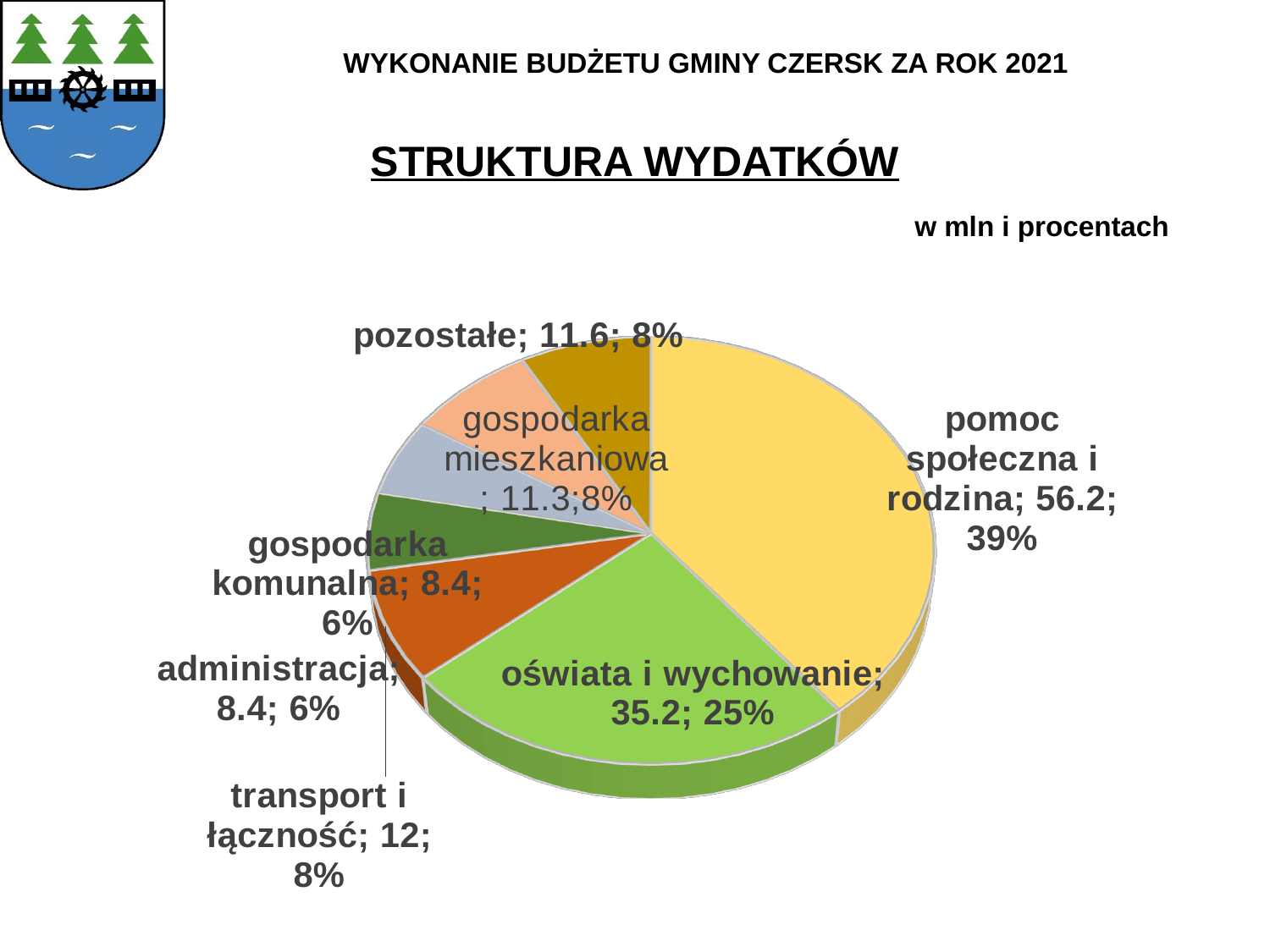
Which category has the largest slice of the pie? pomoc społeczna i rodzina What kind of chart is shown on the slide? pie chart What is the value in mln for "administracja"? 8.4 What is the difference in mln between "pomoc społeczna i rodzina" and "oświata i wychowanie"? 21 What is the value in mln for "transport i łączność"? 12 What is the title of the chart? STRUKTURA WYDATKÓW Which is larger, the value for "pozostałe" or the value for "gospodarka mieszkaniowa"? pozostałe What is the value in mln for "pomoc społeczna i rodzina"? 56.2 What percentage share does "oświata i wychowanie" have? 25% What percentage share does "pomoc społeczna i rodzina" have? 39% How many slices does the pie chart have? 7 What is the value in mln for "gospodarka mieszkaniowa"? 11.3